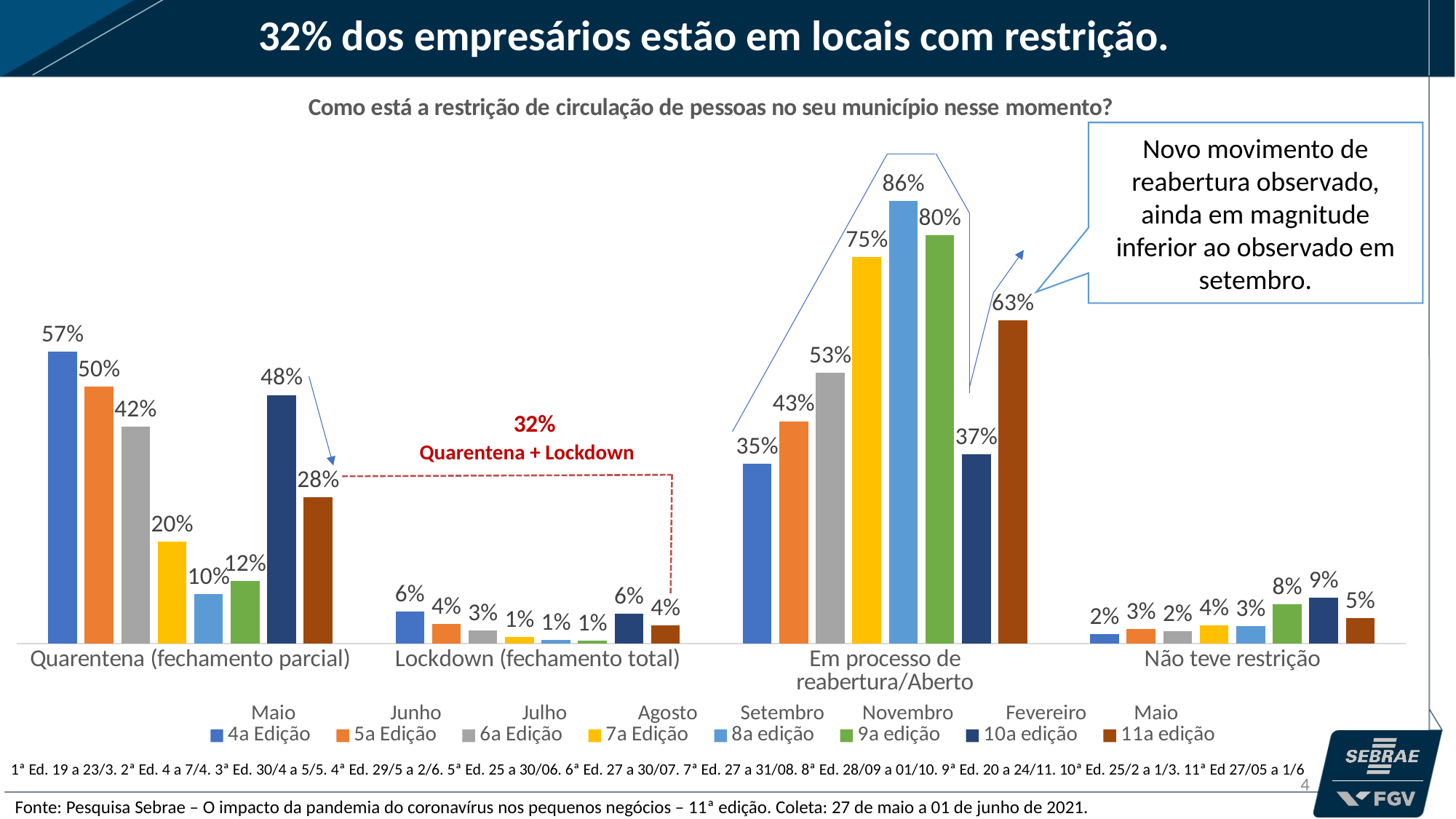
What is the difference between the 8a edição and 11a edição values in the 'Em processo de reabertura/Aberto' category? 23% In the 'Quarentena (fechamento parcial)' category, which is larger: the value for 10a edição or for 11a edição? 10a edição What is the value for 8a edição in the 'Em processo de reabertura/Aberto' category? 86% What is the value for 10a edição in the 'Não teve restrição' category? 9% How many series does the legend list? 8 What kind of chart is shown on the slide? Bar chart How many categories are shown on the x axis of the chart? 4 Which month is shown above the legend entry '9a edição'? Novembro What is the total of the 11a edição values for 'Quarentena (fechamento parcial)' and 'Lockdown (fechamento total)' combined, as highlighted on the slide? 32% What is the value for 11a edição in the 'Quarentena (fechamento parcial)' category? 28% Which edition has the highest value in the 'Quarentena (fechamento parcial)' category? 4a Edição Which edition has the lowest value in the 'Em processo de reabertura/Aberto' category? 4a Edição